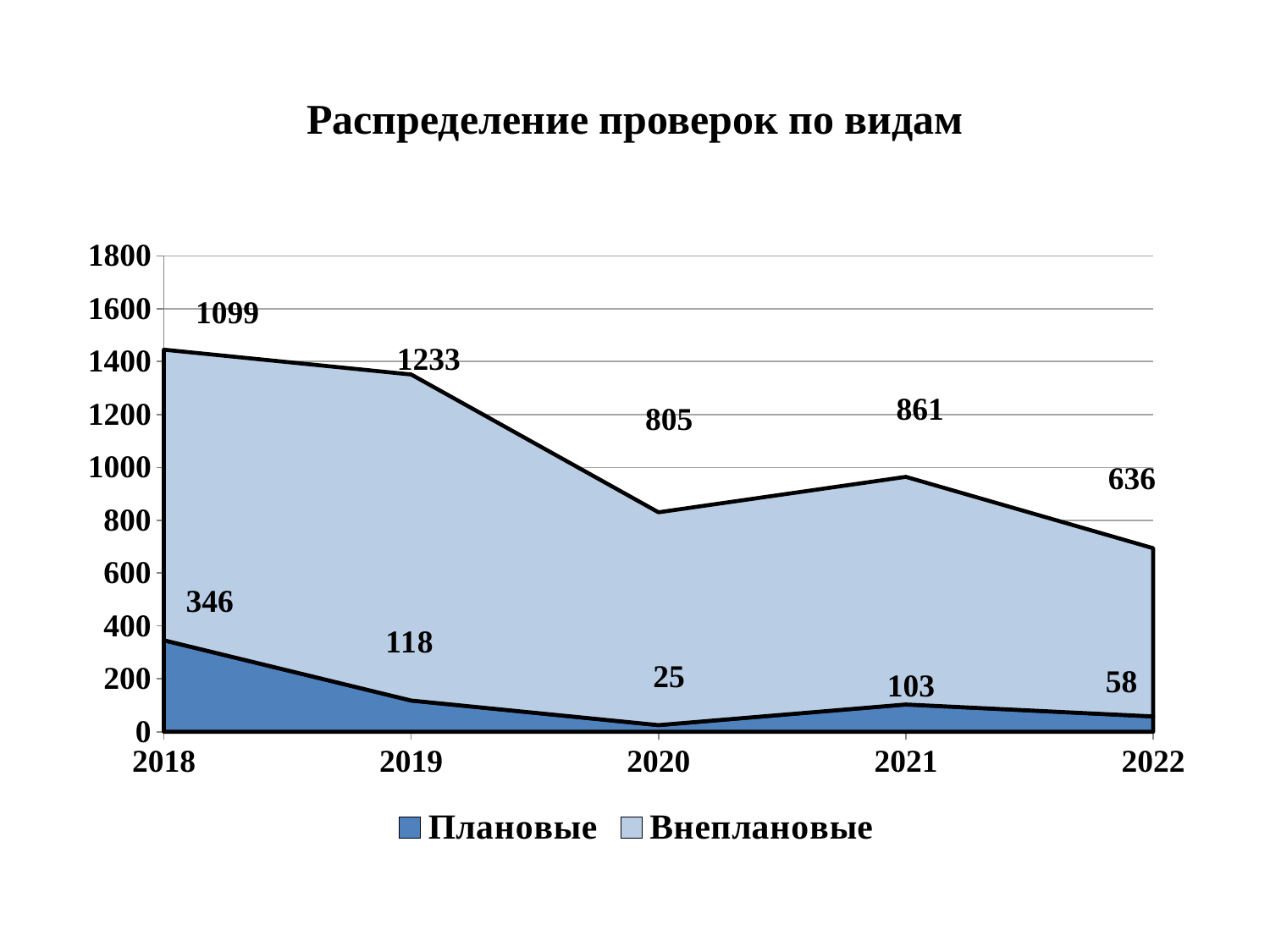
How many years are shown on the x axis? 5 What is the value for Плановые in 2020? 25 How many series does the legend list? 2 What is the value for Плановые in 2018? 346 What is the value for Внеплановые in 2019? 1233 In which year is the Плановые value lowest? 2020 What is the title of the chart? Распределение проверок по видам What is the difference between the Внеплановые values in 2018 and 2022? 463 In which year is the Внеплановые value highest? 2019 What kind of chart is shown on the slide? area chart What is the combined total of Плановые and Внеплановые in 2020? 830 Which is larger: the Плановые value in 2021 or in 2022? 2021